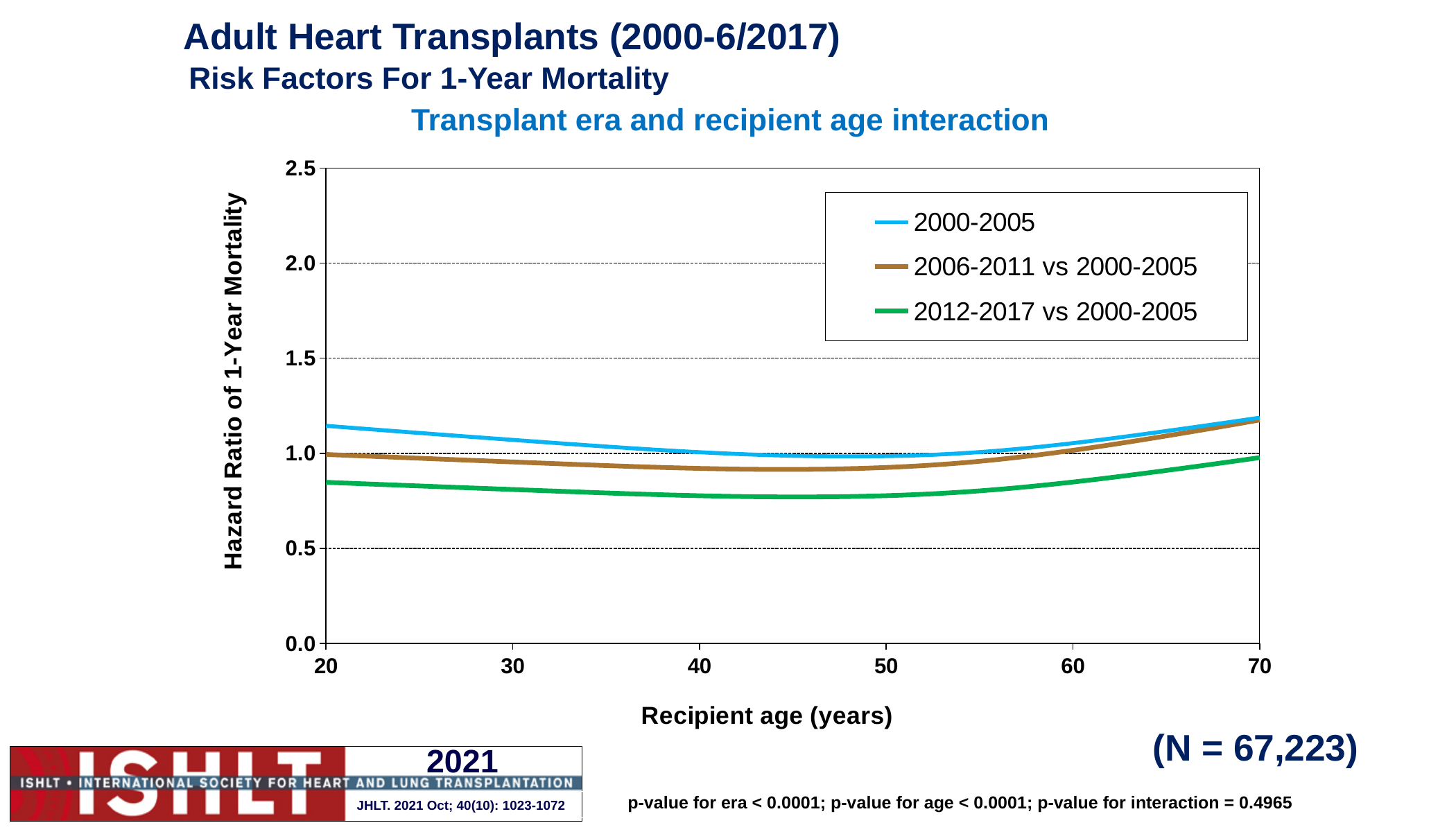
Is the hazard ratio for the 2012-2017 vs 2000-2005 series at recipient age 40 greater or less than 1.0? less Is the hazard ratio for the 2000-2005 series at recipient age 20 greater or less than 1.0? greater At recipient age 30, which series has the larger hazard ratio: 2006-2011 vs 2000-2005 or 2012-2017 vs 2000-2005? 2006-2011 vs 2000-2005 What kind of chart is shown on the slide? line chart Is the hazard ratio for the 2006-2011 vs 2000-2005 series at recipient age 40 greater or less than 1.0? less Does the hazard ratio for the 2012-2017 vs 2000-2005 series rise or fall between recipient age 50 and 70? rise Which series has the lowest hazard ratio at recipient age 40? 2012-2017 vs 2000-2005 What is the title of the chart? Transplant era and recipient age interaction How many series does the legend list? 3 Which series has the highest hazard ratio at recipient age 40? 2000-2005 Which series is shown in green in the legend? 2012-2017 vs 2000-2005